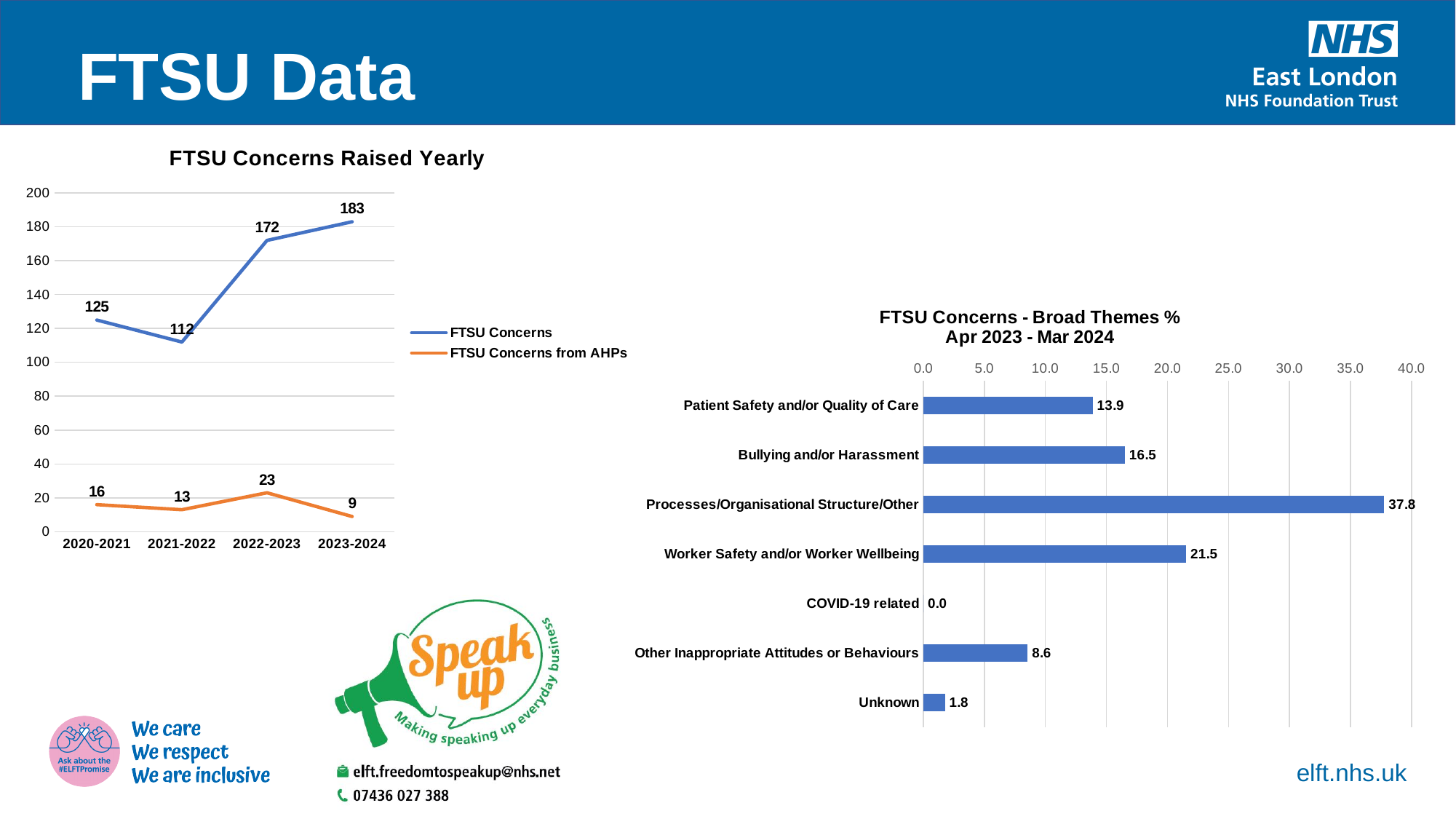
In the 'FTSU Concerns - Broad Themes %' chart, how many themes are shown? 7 In the 'FTSU Concerns Raised Yearly' chart, what is the difference between FTSU Concerns in 2022-2023 and 2021-2022? 60 In the 'FTSU Concerns - Broad Themes %' chart, which is larger: Bullying and/or Harassment or Patient Safety and/or Quality of Care? Bullying and/or Harassment In the 'FTSU Concerns Raised Yearly' chart, what kind of chart is it? Line chart In the 'FTSU Concerns Raised Yearly' chart, does the FTSU Concerns from AHPs series rise or fall from 2022-2023 to 2023-2024? Fall In the 'FTSU Concerns - Broad Themes %' chart, what is the difference between Processes/Organisational Structure/Other and Other Inappropriate Attitudes or Behaviours? 29.2 In the 'FTSU Concerns Raised Yearly' chart, what is the value of FTSU Concerns for 2023-2024? 183 In the 'FTSU Concerns Raised Yearly' chart, which year has the lowest value for FTSU Concerns? 2021-2022 In the 'FTSU Concerns - Broad Themes %' chart, which theme has the highest value? Processes/Organisational Structure/Other In the 'FTSU Concerns - Broad Themes %' chart, what is the value for Worker Safety and/or Worker Wellbeing? 21.5 In the 'FTSU Concerns Raised Yearly' chart, how many series does the legend list? 2 In the 'FTSU Concerns Raised Yearly' chart, what is the value of FTSU Concerns from AHPs for 2022-2023? 23